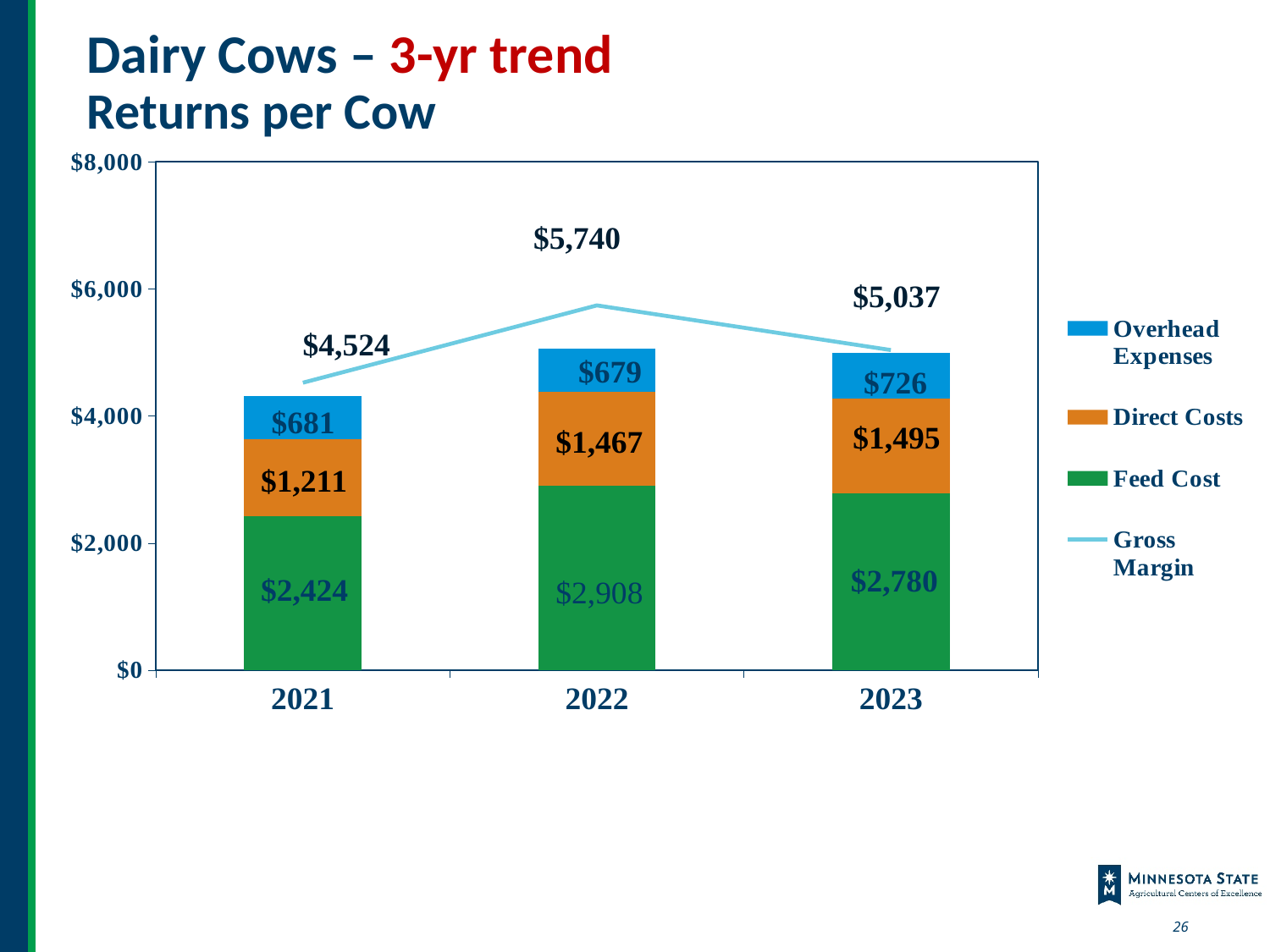
Which series is shown as a line rather than a bar segment? Gross Margin What is the Feed Cost for 2022? $2,908 How many years are shown on the x axis? 3 What is the Gross Margin value shown for 2023? $5,037 What are the Overhead Expenses for 2021? $681 How many series does the legend list? 4 Which year has the lowest Feed Cost? 2021 Which year has the highest Gross Margin? 2022 What kind of chart is this? Stacked bar chart with a line What is the total of the stacked bar for 2021 (Feed Cost, Direct Costs and Overhead Expenses)? $4,316 Which is larger, the Direct Costs in 2023 or in 2022? 2023 What is the difference between the Gross Margin in 2022 and in 2021? $1,216